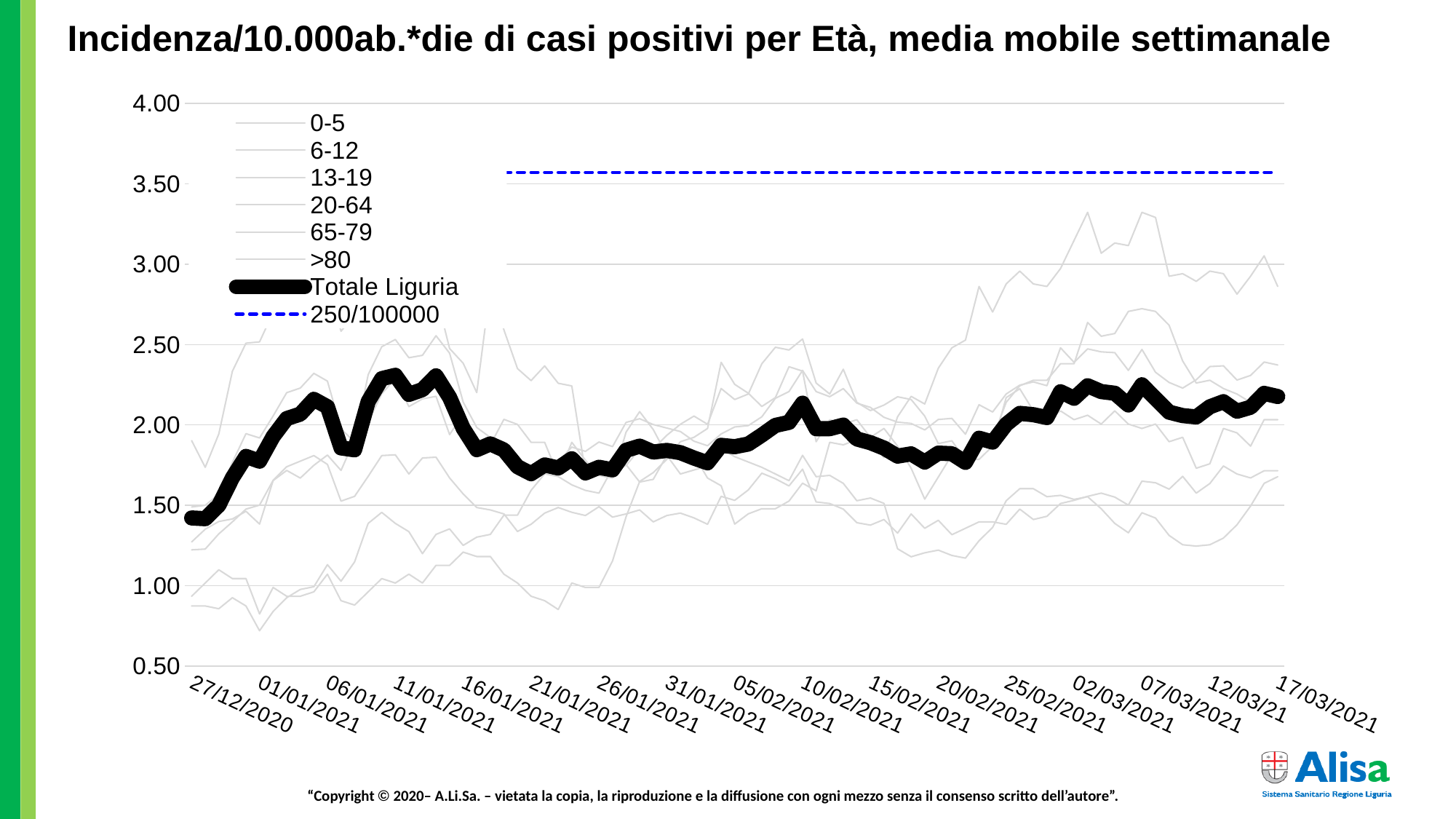
Is the value of Totale Liguria on 17/03/2021 greater or less than 2.00? greater What kind of chart is shown on the slide? line chart Which legend entry is drawn as a blue dashed line? 250/100000 How many date labels are shown on the x axis? 17 Which is larger for Totale Liguria: the value on 27/12/2020 or the value on 17/03/2021? 17/03/2021 How many series does the legend list? 8 Does the Totale Liguria line rise or fall between 27/12/2020 and 06/01/2021? rise Is the 250/100000 dashed line greater or less than 3.50? greater Is the value of Totale Liguria on 21/01/2021 greater or less than 2.00? less What is the title of the chart? Incidenza/10.000ab.*die di casi positivi per Età, media mobile settimanale